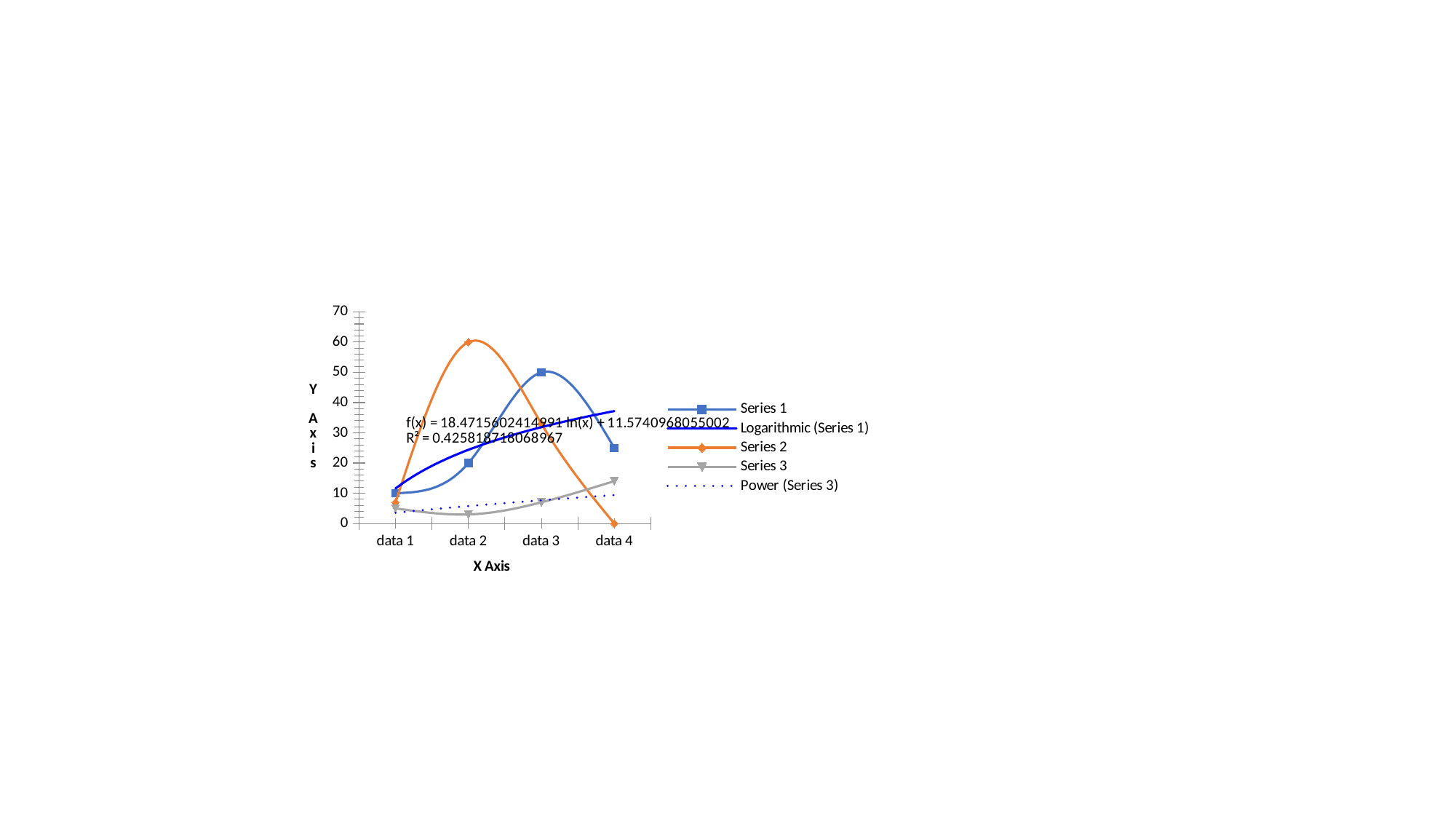
Is the value of Series 2 at data 2 greater or less than 50? greater What kind of chart is shown on the slide? line chart What is the R² value shown for the logarithmic trendline? 0.425818718068967 At which category does Series 2 reach its highest value? data 2 How many categories are shown on the x axis? 4 Is the value of Series 3 at data 4 greater or less than 20? less At which category does Series 1 reach its highest value? data 3 At which category does Series 2 reach its lowest value? data 4 How many entries does the legend list? 5 At data 4, which is larger: Series 2 or Series 3? Series 3 Does Series 3 rise or fall from data 2 to data 4? rise At data 2, which is larger: Series 1 or Series 2? Series 2